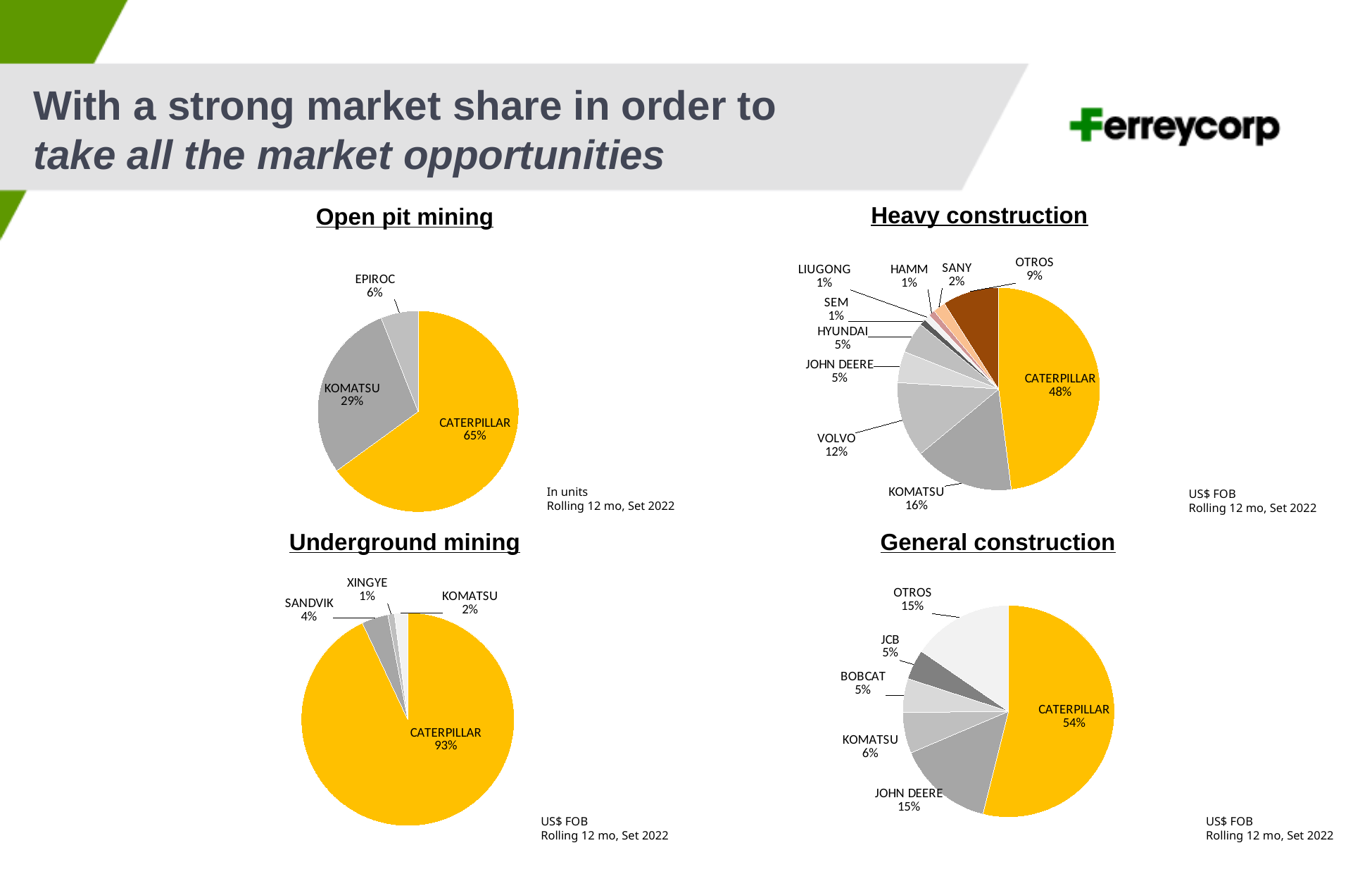
In the Heavy construction chart, what share does VOLVO hold? 12% In the General construction chart, what share does JOHN DEERE hold? 15% In the General construction chart, what is the difference between the CATERPILLAR and OTROS shares? 39 percentage points In the Open pit mining chart, how many slices does the pie have? 3 In the Underground mining chart, which brand has the smallest share? XINGYE In the Open pit mining chart, which brand has the largest share? CATERPILLAR In the Heavy construction chart, which is larger, the share for HYUNDAI or the share for OTROS? OTROS What type of chart is used for the four market share charts on the slide? Pie chart In the Heavy construction chart, how many brands/categories are shown? 10 In the Underground mining chart, what share does CATERPILLAR hold? 93% In the Heavy construction chart, what is the difference between the CATERPILLAR and KOMATSU shares? 32 percentage points In the Open pit mining chart, what share does KOMATSU hold? 29%